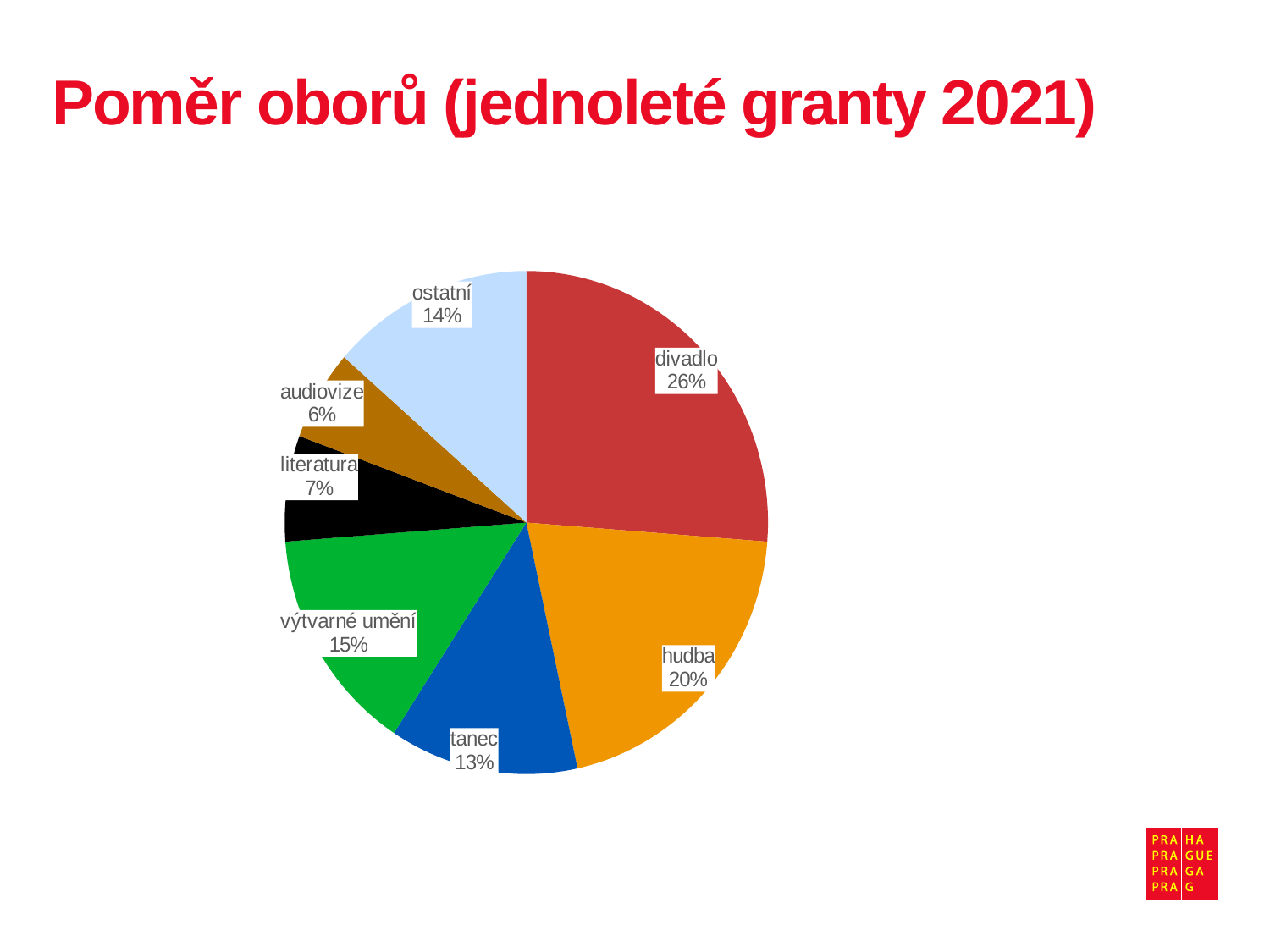
What share of the pie does výtvarné umění have? 15% What is the title of the slide? Poměr oborů (jednoleté granty 2021) How many categories are shown in the pie chart? 7 What share of the pie does audiovize have? 6% Which is larger, the share for tanec or the share for výtvarné umění? výtvarné umění What share of the pie does divadlo have? 26% What share of the pie does hudba have? 20% Which category has the smallest slice of the pie? audiovize Which category has the largest slice of the pie? divadlo What kind of chart is shown on the slide? pie chart What is the difference in percentage points between divadlo and hudba? 6 What is the difference in percentage points between ostatní and literatura? 7